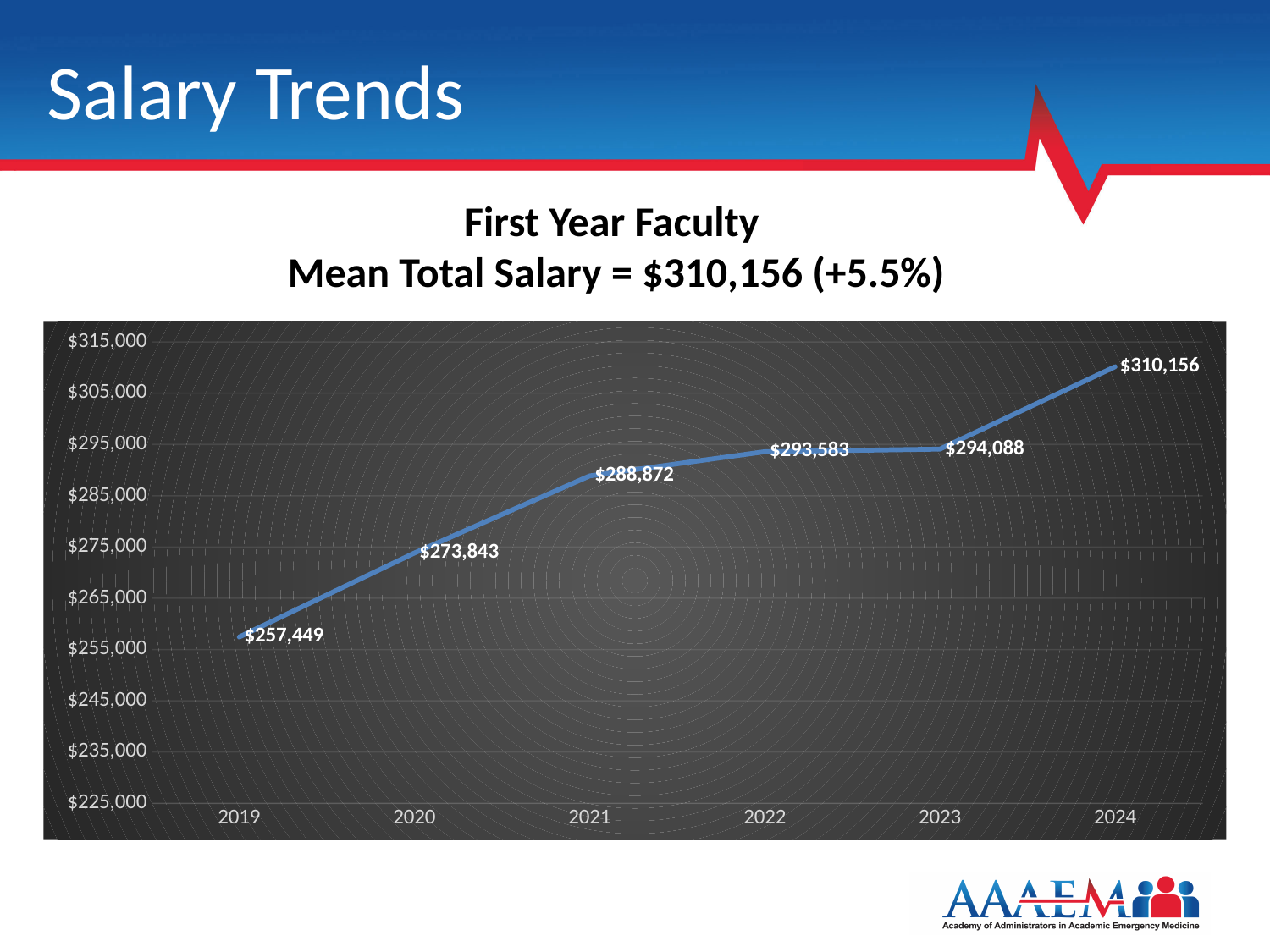
What is the mean total salary for first year faculty in 2023? $294,088 What kind of chart is shown on the slide? Line chart What is the mean total salary for first year faculty in 2021? $288,872 What is the difference between the 2020 and 2019 mean total salaries? $16,394 Which year has a higher mean total salary, 2020 or 2022? 2022 How many years are plotted on the chart? 6 What is the mean total salary for first year faculty in 2019? $257,449 Do the mean total salary values rise or fall from 2019 to 2024? Rise Which year has the highest mean total salary on the chart? 2024 Which year has the lowest mean total salary on the chart? 2019 What is the difference between the 2024 and 2019 mean total salaries? $52,707 What is the mean total salary for first year faculty in 2024? $310,156